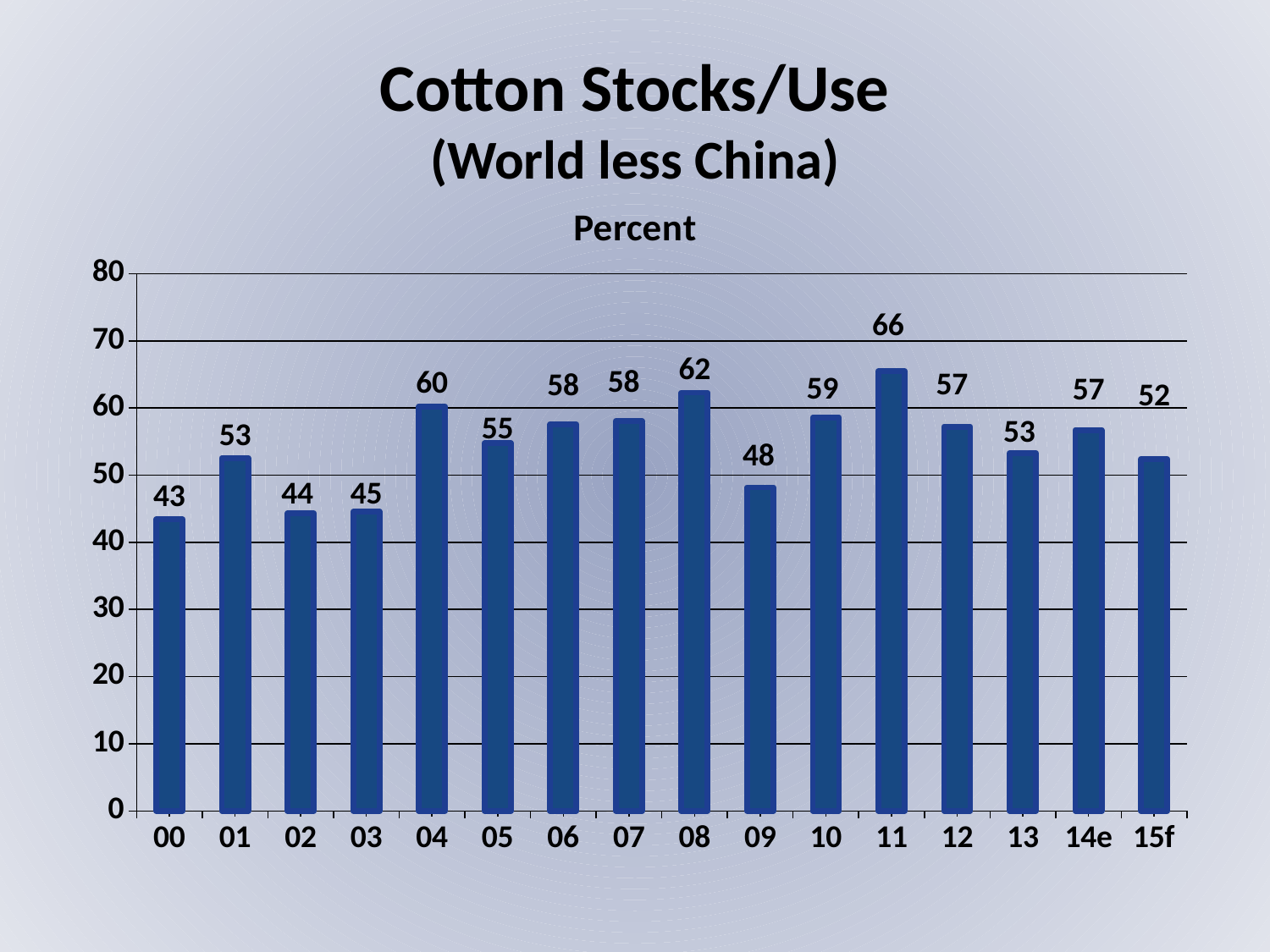
What is the value shown for 00? 43 What kind of chart is shown on the slide? bar chart Which is larger, the value for 04 or the value for 05? 04 Is the value for 09 greater or less than 50? less What is the value shown for 15f? 52 What is the title of the chart? Cotton Stocks/Use (World less China) What is the difference between the values for 11 and 09? 18 What is the cotton stocks/use value for 11? 66 Which year has the lowest stocks/use value? 00 How many years are shown on the x axis? 16 What is the difference between the values for 08 and 01? 9 Which year has the highest stocks/use value? 11